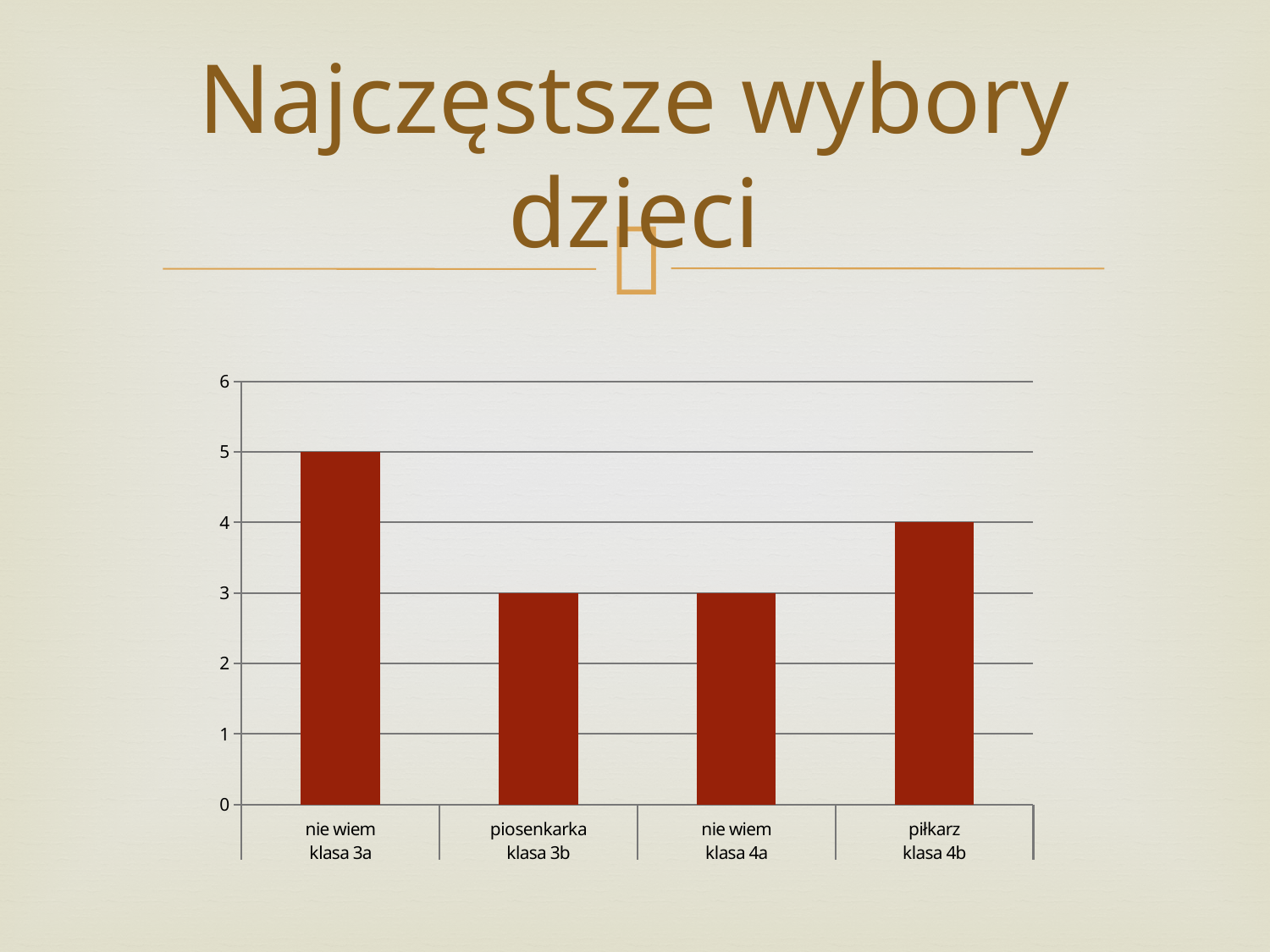
What is the difference between the values for 'nie wiem klasa 3a' and 'piłkarz klasa 4b'? 1 What kind of chart is shown on the slide? bar chart What is the title of the slide? Najczęstsze wybory dzieci How many categories are shown on the chart? 4 Which is larger, the value for 'piłkarz klasa 4b' or the value for 'nie wiem klasa 4a'? piłkarz klasa 4b Is the value for 'nie wiem klasa 3a' greater or less than 4? greater What is the value for 'nie wiem klasa 4a'? 3 What is the value for 'piosenkarka klasa 3b'? 3 What is the value for 'piłkarz klasa 4b'? 4 Which category has the highest value? nie wiem klasa 3a What is the difference between the values for 'piłkarz klasa 4b' and 'piosenkarka klasa 3b'? 1 What is the value for 'nie wiem klasa 3a'? 5